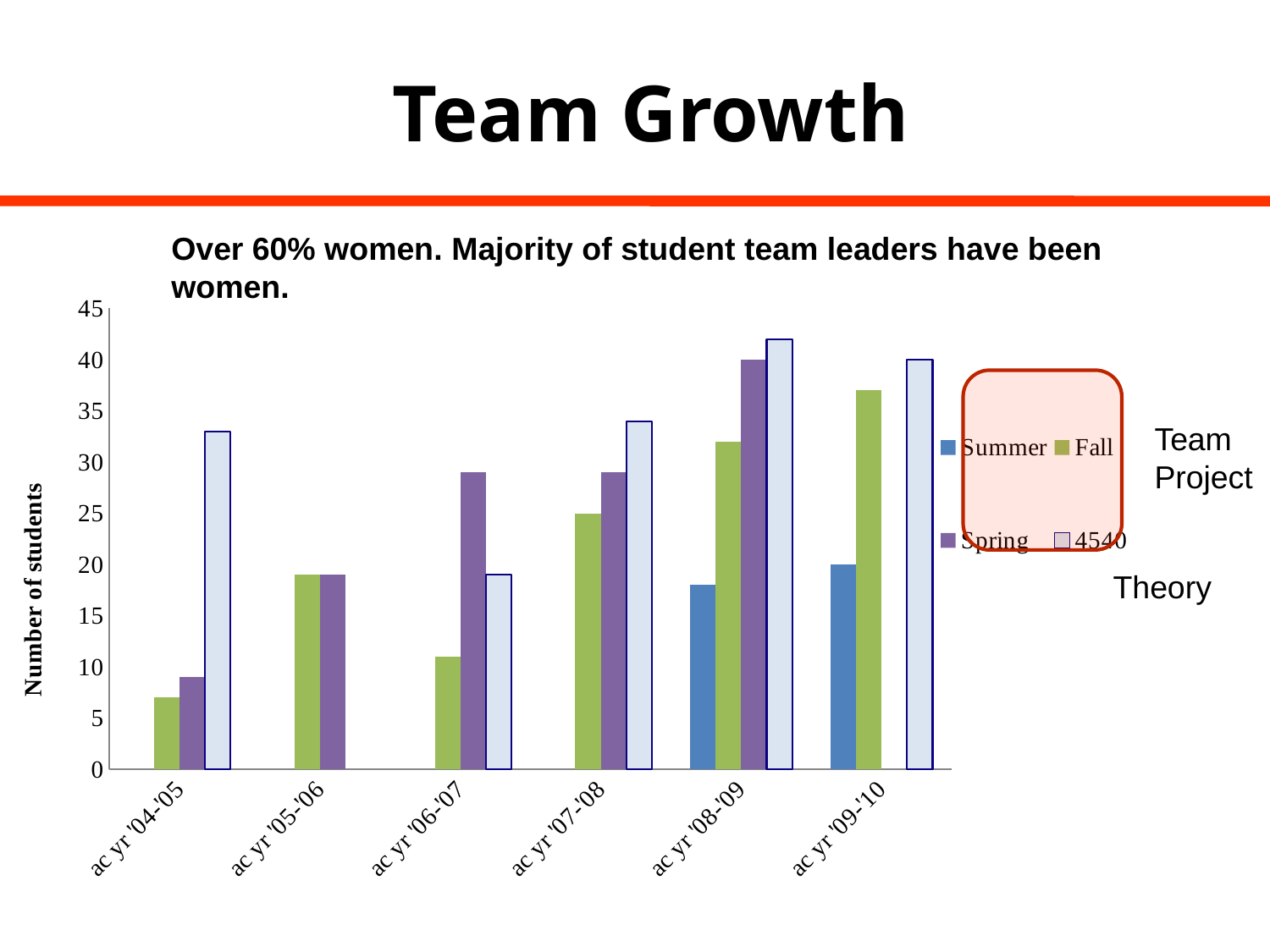
Which academic year has the tallest bar in the chart? ac yr '08-'09 In ac yr '06-'07, which is larger, the Fall value or the Spring value? Spring How many series does the chart legend list? 4 How many academic years are shown on the x axis of the chart? 6 What kind of chart is shown on the slide? bar chart Which series has the lowest bar in ac yr '04-'05? Fall Is the 4540 value for ac yr '04-'05 greater or less than 30? greater Which series is shown in green in the chart legend? Fall Is the Fall value for ac yr '09-'10 greater or less than 35? greater Is the Summer value for ac yr '08-'09 greater or less than 20? less Does the Fall series rise or fall from ac yr '06-'07 to ac yr '09-'10? rise What is the title of the vertical axis of the chart? Number of students